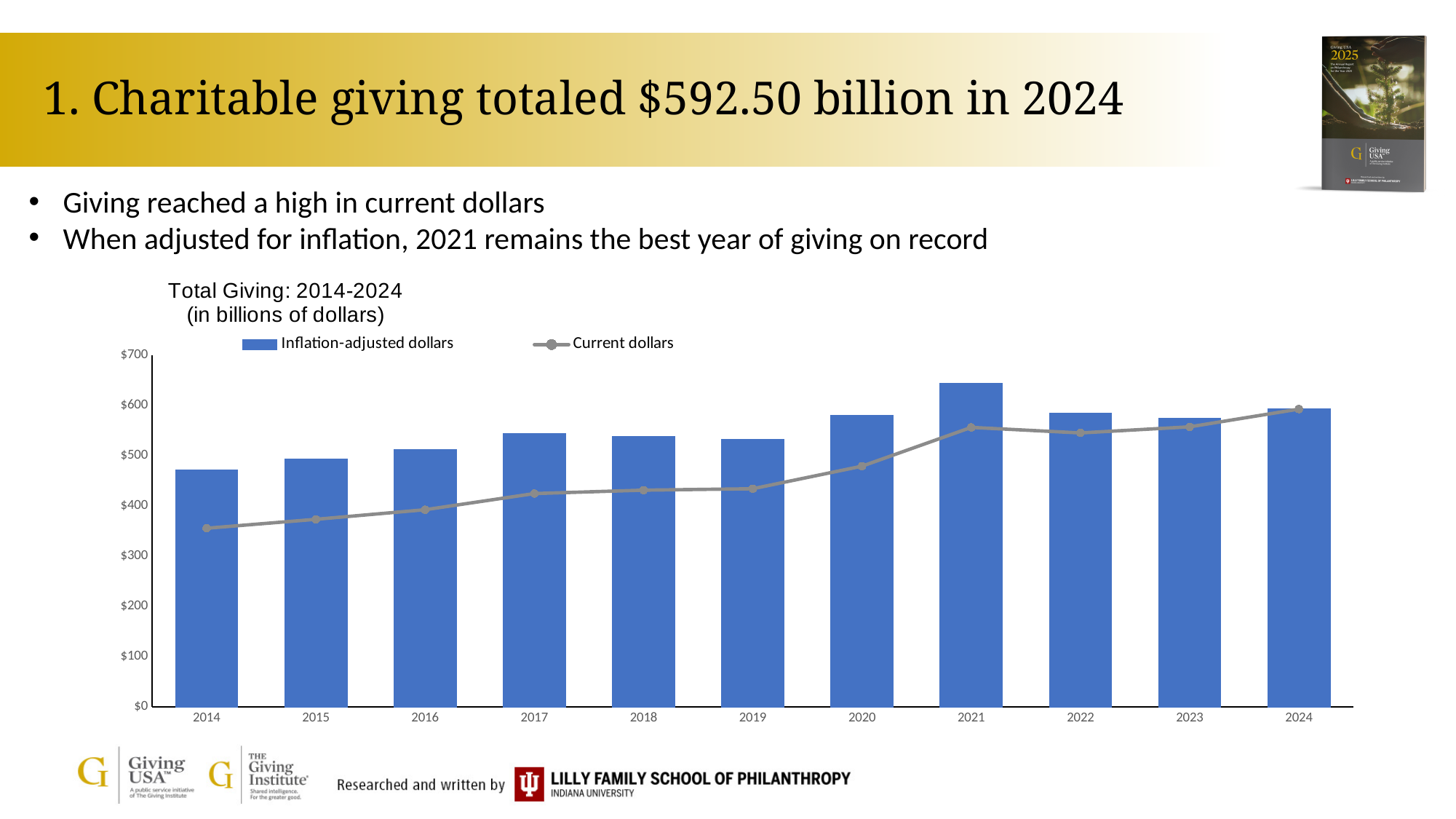
What kind of chart is used to show inflation-adjusted dollars in the Total Giving chart? bar chart How many years are shown on the x axis of the Total Giving chart? 11 Is the current dollars value for 2014 greater or less than $400? less Does the current dollars line generally rise or fall from 2014 to 2024? rise Which year has the highest current dollars value? 2024 How many series does the legend of the Total Giving chart list? 2 Which year has the highest inflation-adjusted dollars bar? 2021 Which is larger, the inflation-adjusted dollars bar for 2021 or for 2024? 2021 What are the two legend entries in the Total Giving chart? Inflation-adjusted dollars and Current dollars Is the inflation-adjusted dollars value for 2021 greater or less than $600? greater Which year has the lowest inflation-adjusted dollars bar? 2014 Is the current dollars value for 2020 greater or less than $500? less